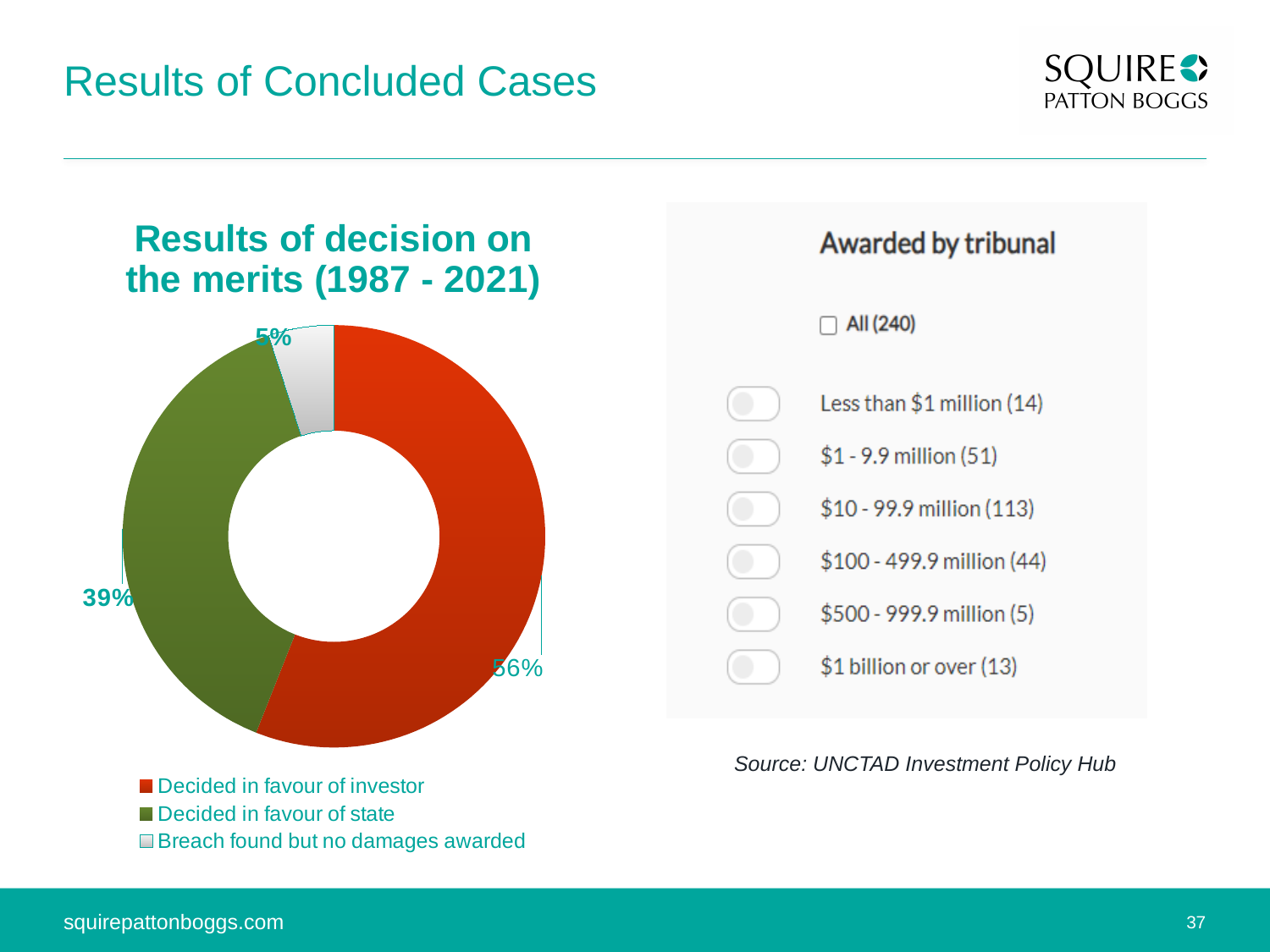
What is the combined share of cases decided in favour of investor and cases decided in favour of state? 95% How many categories does the chart show? 3 Which category has the smallest share of the chart? Breach found but no damages awarded What is the title of the chart on the slide? Results of decision on the merits (1987 - 2021) Which category has the largest share of the chart? Decided in favour of investor What colour represents cases decided in favour of state in the chart? Green What is the difference in percentage points between cases decided in favour of investor and cases decided in favour of state? 17 What kind of chart is shown on the slide? Doughnut chart What percentage of cases had a breach found but no damages awarded? 5% What percentage of cases were decided in favour of investor? 56% What percentage of cases were decided in favour of state? 39% Which is larger: the share decided in favour of state or the share with breach found but no damages awarded? Decided in favour of state